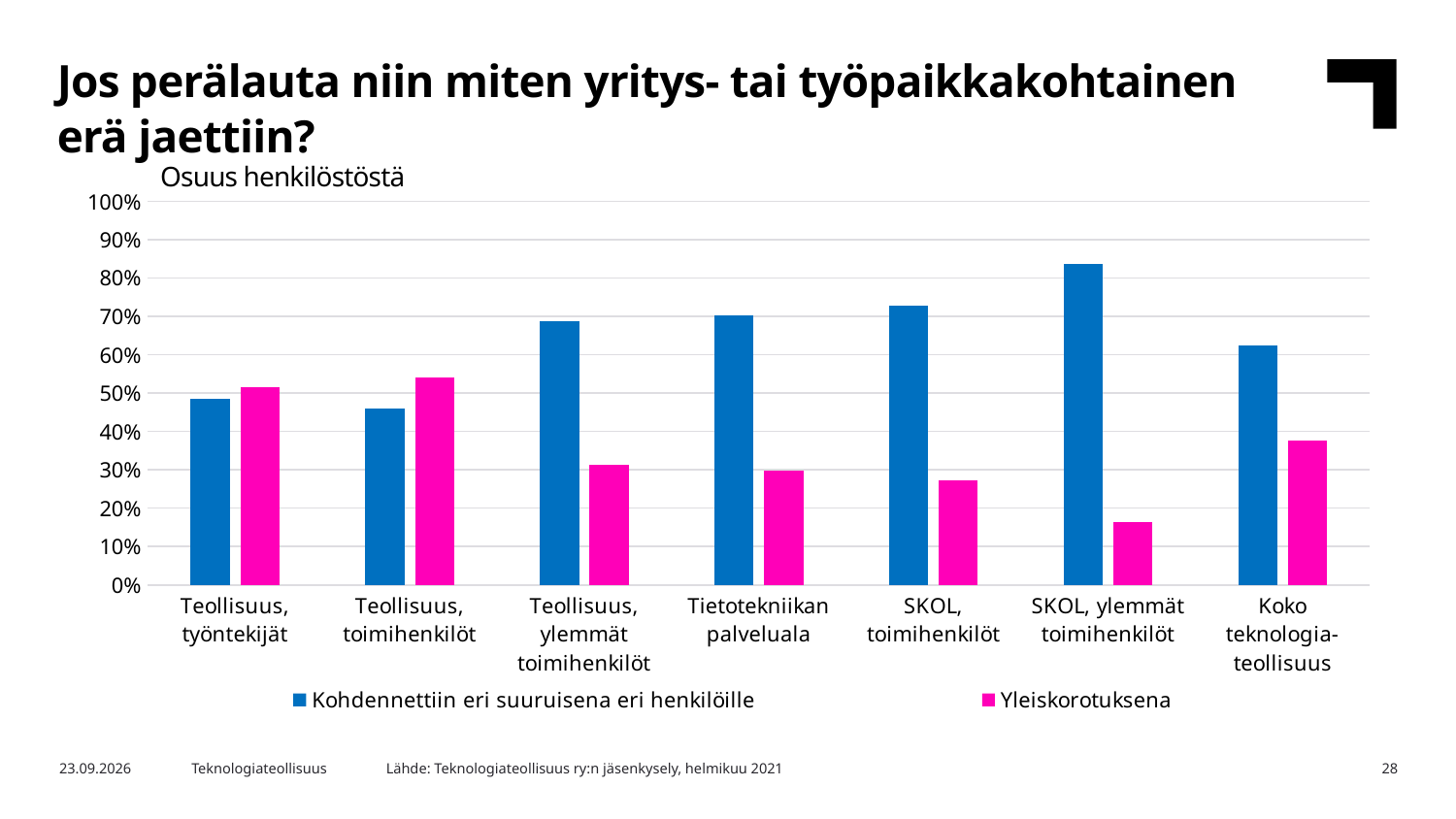
Which category has the lowest value for the series 'Yleiskorotuksena'? SKOL, ylemmät toimihenkilöt What is the label shown above the vertical axis of the chart? Osuus henkilöstöstä Is the value for 'Kohdennettiin eri suuruisena eri henkilöille' in the category 'SKOL, ylemmät toimihenkilöt' greater or less than 80%? greater Which category has the highest value for the series 'Kohdennettiin eri suuruisena eri henkilöille'? SKOL, ylemmät toimihenkilöt What kind of chart is shown on the slide? bar chart In the category 'Teollisuus, toimihenkilöt', which series has the larger value: 'Kohdennettiin eri suuruisena eri henkilöille' or 'Yleiskorotuksena'? Yleiskorotuksena Is the value for 'Yleiskorotuksena' in the category 'Koko teknologiateollisuus' greater or less than 40%? less How many categories are shown on the x axis of the chart? 7 Is the value for 'Yleiskorotuksena' in the category 'SKOL, ylemmät toimihenkilöt' greater or less than 20%? less How many series does the legend list? 2 In the category 'SKOL, toimihenkilöt', which series has the larger value: 'Kohdennettiin eri suuruisena eri henkilöille' or 'Yleiskorotuksena'? Kohdennettiin eri suuruisena eri henkilöille